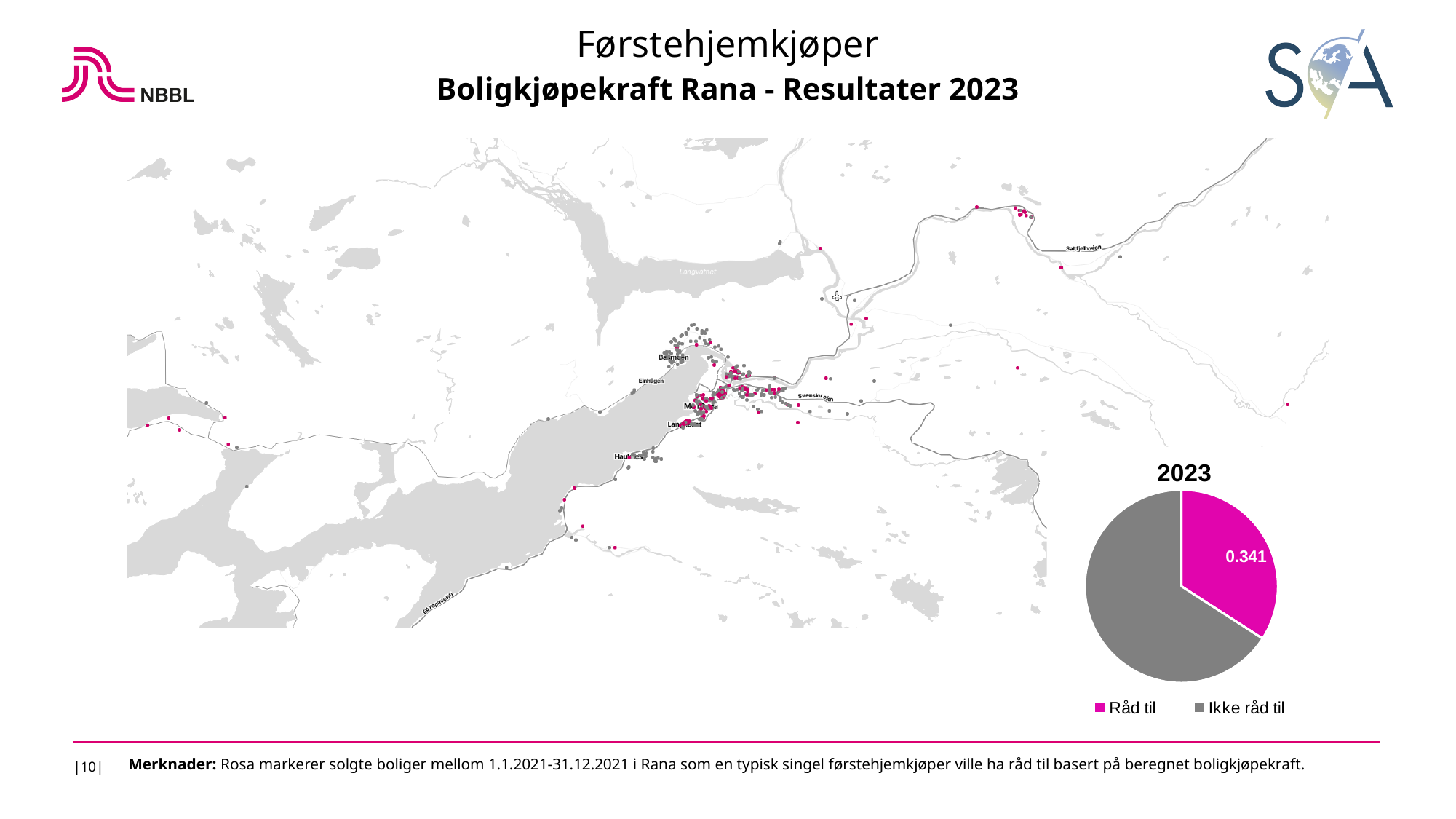
How many categories does the pie chart's legend list? 2 How many slices does the pie chart have? 2 In the pie chart, what value is shown for "Råd til"? 0.341 What colour is the "Råd til" slice in the pie chart? pink Which slice of the pie chart is the largest? Ikke råd til What kind of chart is shown in the lower right of the slide? pie chart What is the title of the pie chart? 2023 What share of the pie does the "Råd til" slice represent, as labelled? 0.341 In the pie chart, which is larger: "Råd til" or "Ikke råd til"? Ikke råd til Which slice of the pie chart is the smallest? Råd til